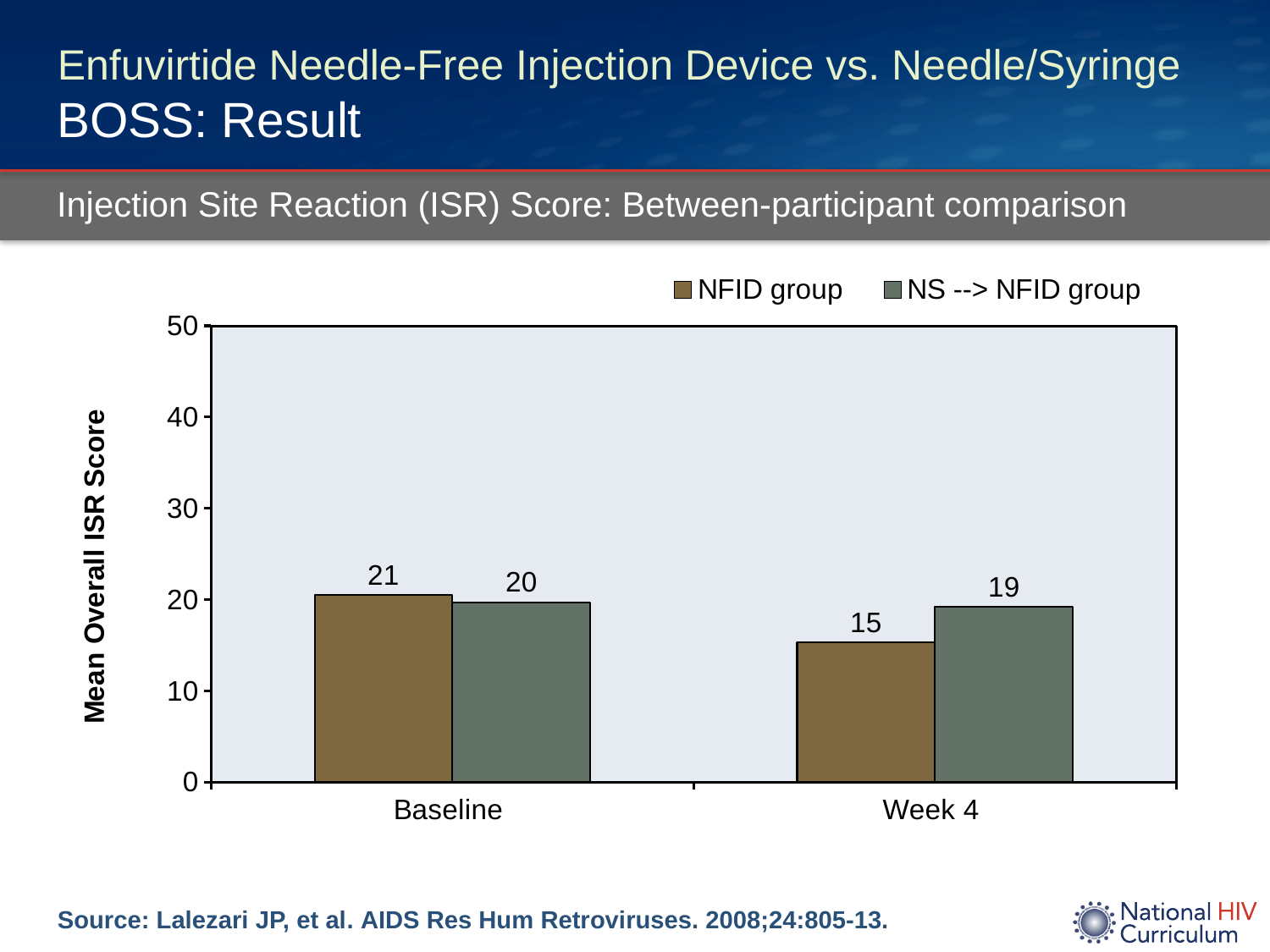
At Week 4, which group has the higher Mean Overall ISR Score? NS --> NFID group What kind of chart is shown on the slide? Bar chart What is the Mean Overall ISR Score for the NFID group at Week 4? 15 By how much did the NFID group's Mean Overall ISR Score fall from Baseline to Week 4? 6 Is the NFID group's Baseline value greater or less than 20? greater What is the difference between the NS --> NFID group and the NFID group at Week 4? 4 What is the Mean Overall ISR Score for the NS --> NFID group at Week 4? 19 Which bar has the lowest Mean Overall ISR Score? NFID group at Week 4 What is the Mean Overall ISR Score for the NS --> NFID group at Baseline? 20 How many series does the legend list? 2 Does the NFID group's Mean Overall ISR Score rise or fall from Baseline to Week 4? Fall What is the Mean Overall ISR Score for the NFID group at Baseline? 21